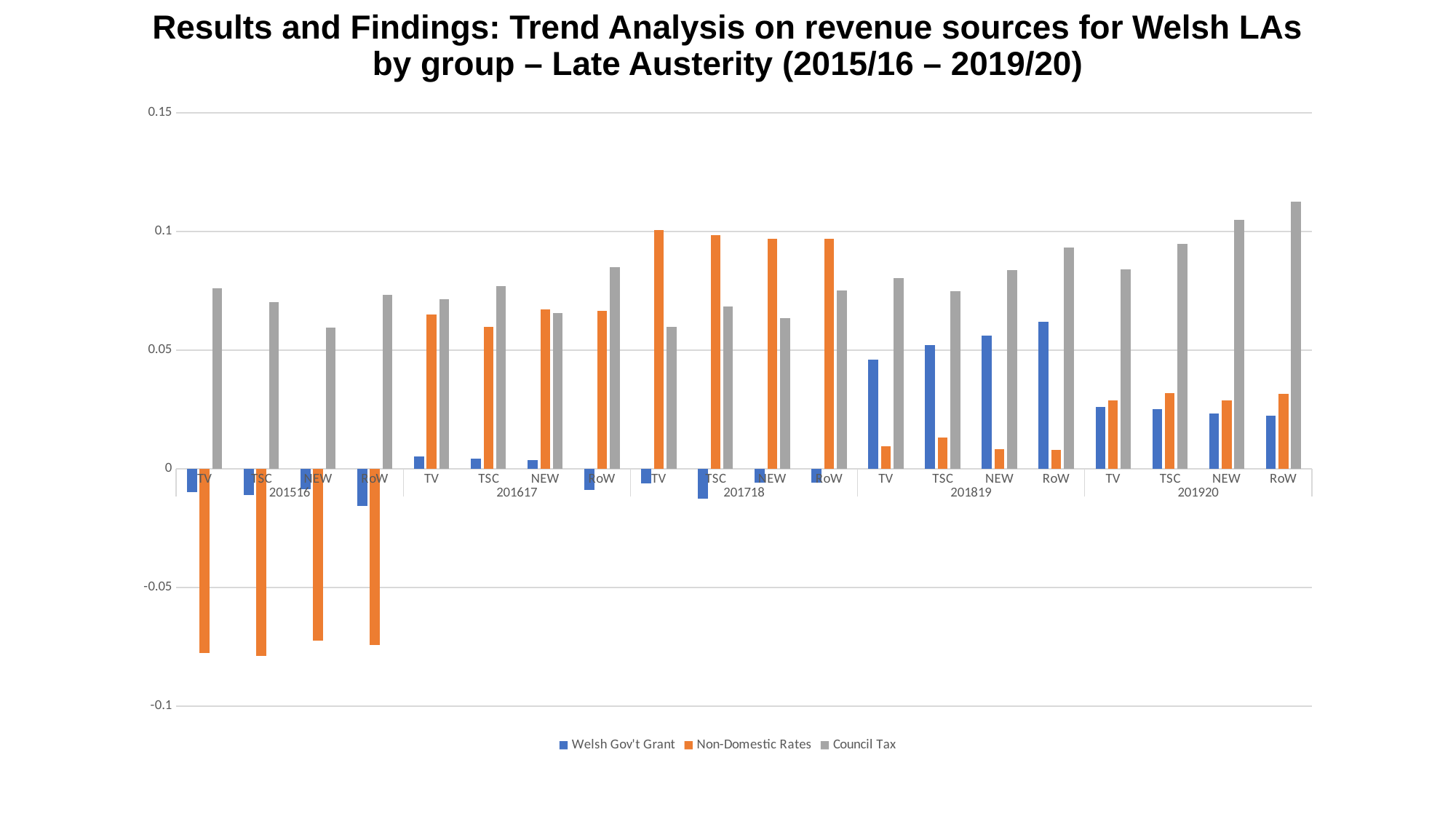
What kind of chart is shown on the slide? bar chart Is the Council Tax value for RoW in 201920 greater or less than 0.1? greater Within the 201920 group, which category has the highest Council Tax bar? RoW In the 201516 group, which series has the lowest (most negative) bars? Non-Domestic Rates Within the 201920 group, do the Council Tax bars rise or fall moving from TV to RoW? rise How many series does the legend list? 3 Is the Non-Domestic Rates value for TV in 201516 greater or less than -0.05? less In 201617 for RoW, which is larger, Council Tax or Non-Domestic Rates? Council Tax Is the Non-Domestic Rates value for TV in 201718 greater or less than 0.05? greater In 201819, which has the larger Welsh Gov't Grant value, TV or RoW? RoW How many year groups (e.g. 201516, 201617) are shown along the x axis? 5 What colour represents Council Tax in the legend? grey